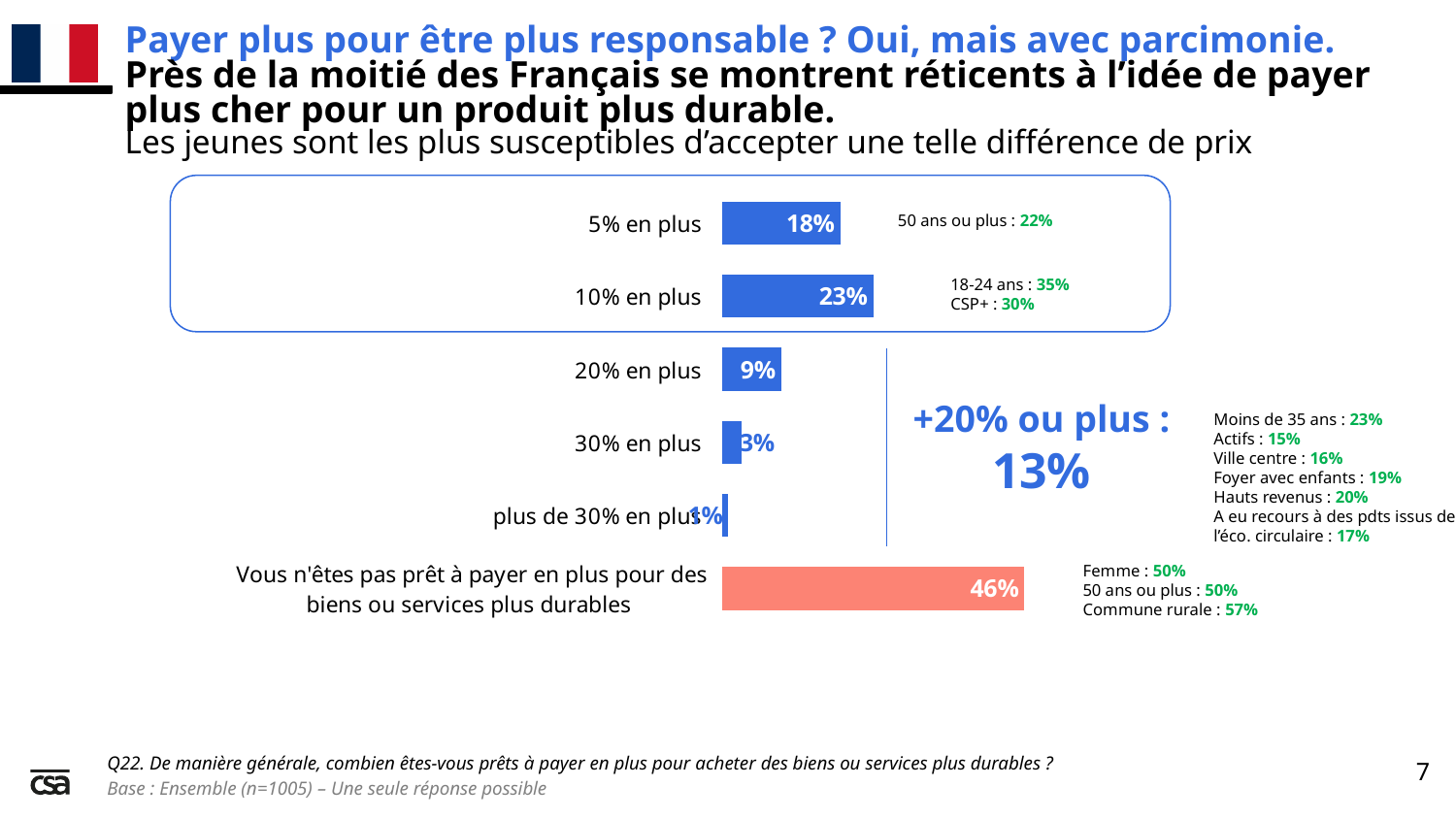
Which is larger: the value for "20% en plus" or the value for "30% en plus"? 20% en plus What combined percentage is shown for "+20% ou plus"? 13% How many categories (bars) does the chart show? 6 Which category has the lowest value in the chart? plus de 30% en plus What percentage of respondents are willing to pay 10% more ("10% en plus")? 23% What percentage of respondents are not ready to pay more for more durable goods or services ("Vous n'êtes pas prêt à payer en plus...")? 46% What is the difference between the values for "10% en plus" and "5% en plus"? 5% What kind of chart is shown on the slide? Bar chart What is the total of the values for "20% en plus", "30% en plus" and "plus de 30% en plus"? 13% What is the value shown for "20% en plus"? 9% Which category has the highest value in the chart? Vous n'êtes pas prêt à payer en plus pour des biens ou services plus durables What is the value shown for "5% en plus"? 18%